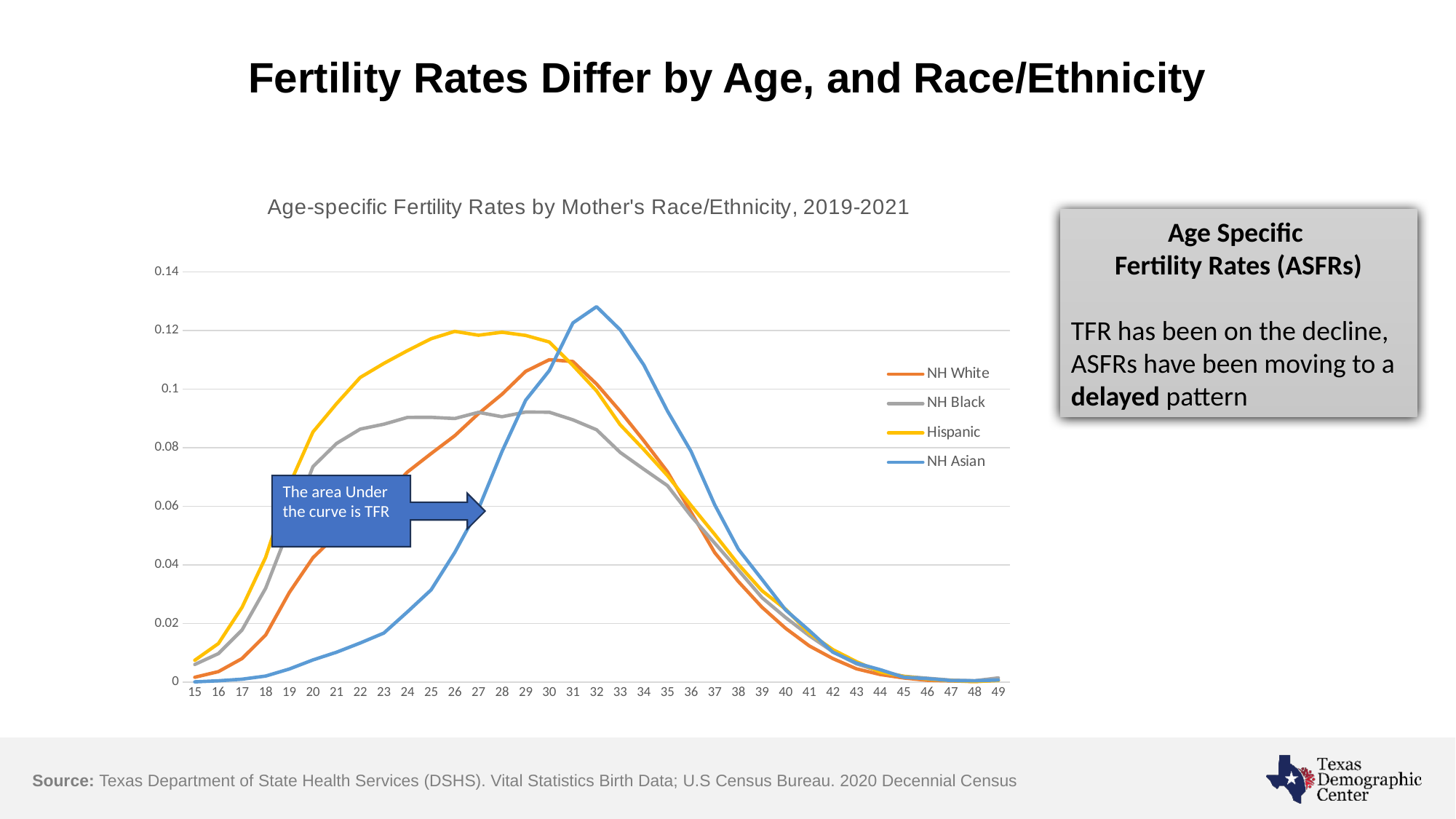
Which series has the lowest value at age 15? NH Asian Which series reaches the highest peak value? NH Asian Is the value for NH Asian at age 32 greater or less than 0.12? greater What kind of chart is shown on the slide? line chart At age 20, which is larger: the Hispanic value or the NH Asian value? Hispanic How many age categories are shown along the x axis? 35 Does the Hispanic line rise or fall between ages 30 and 45? fall At age 32, which is larger: the NH Asian value or the NH Black value? NH Asian Is the value for Hispanic at age 26 greater or less than 0.1? greater Is the value for NH Asian at age 22 greater or less than 0.02? less What is the title of the chart? Age-specific Fertility Rates by Mother's Race/Ethnicity, 2019-2021 How many series does the legend list? 4